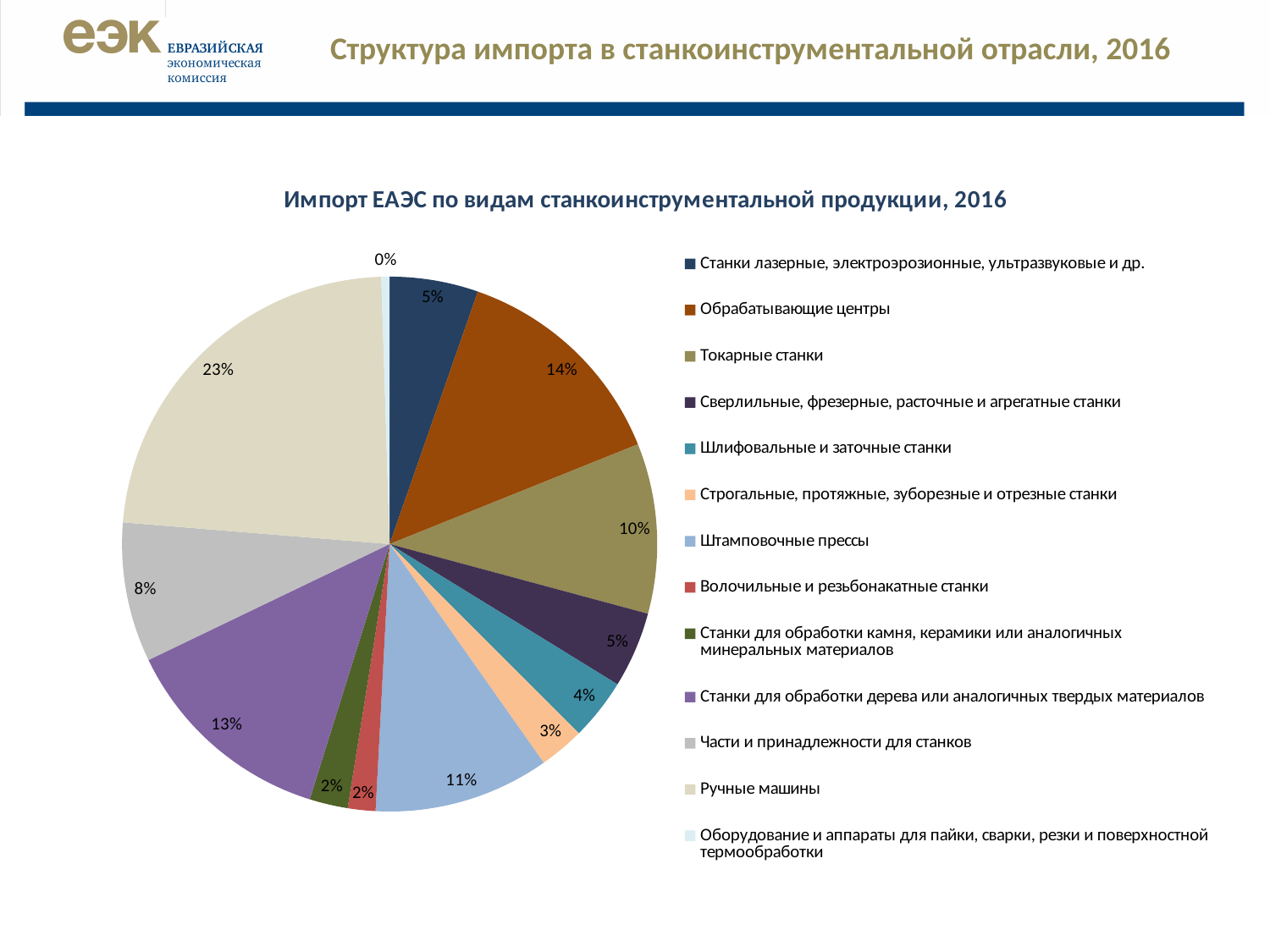
What is the combined share of Шлифовальные и заточные станки and Строгальные, протяжные, зуборезные и отрезные станки? 7% What type of chart is shown on the slide? Pie chart What share of the pie does Ручные машины account for? 23% How many categories are listed in the legend of the pie chart? 13 What is the value shown for Обрабатывающие центры? 14% Which category has the largest slice of the pie? Ручные машины Which category has the smallest share, shown as 0%? Оборудование и аппараты для пайки, сварки, резки и поверхностной термообработки What share is shown for Части и принадлежности для станков? 8% What percentage is shown for Штамповочные прессы? 11% Which is larger: the share for Токарные станки or the share for Станки для обработки дерева или аналогичных твердых материалов? Станки для обработки дерева или аналогичных твердых материалов What is the title of the chart? Импорт ЕАЭС по видам станкоинструментальной продукции, 2016 What is the difference in percentage points between Ручные машины and Обрабатывающие центры? 9